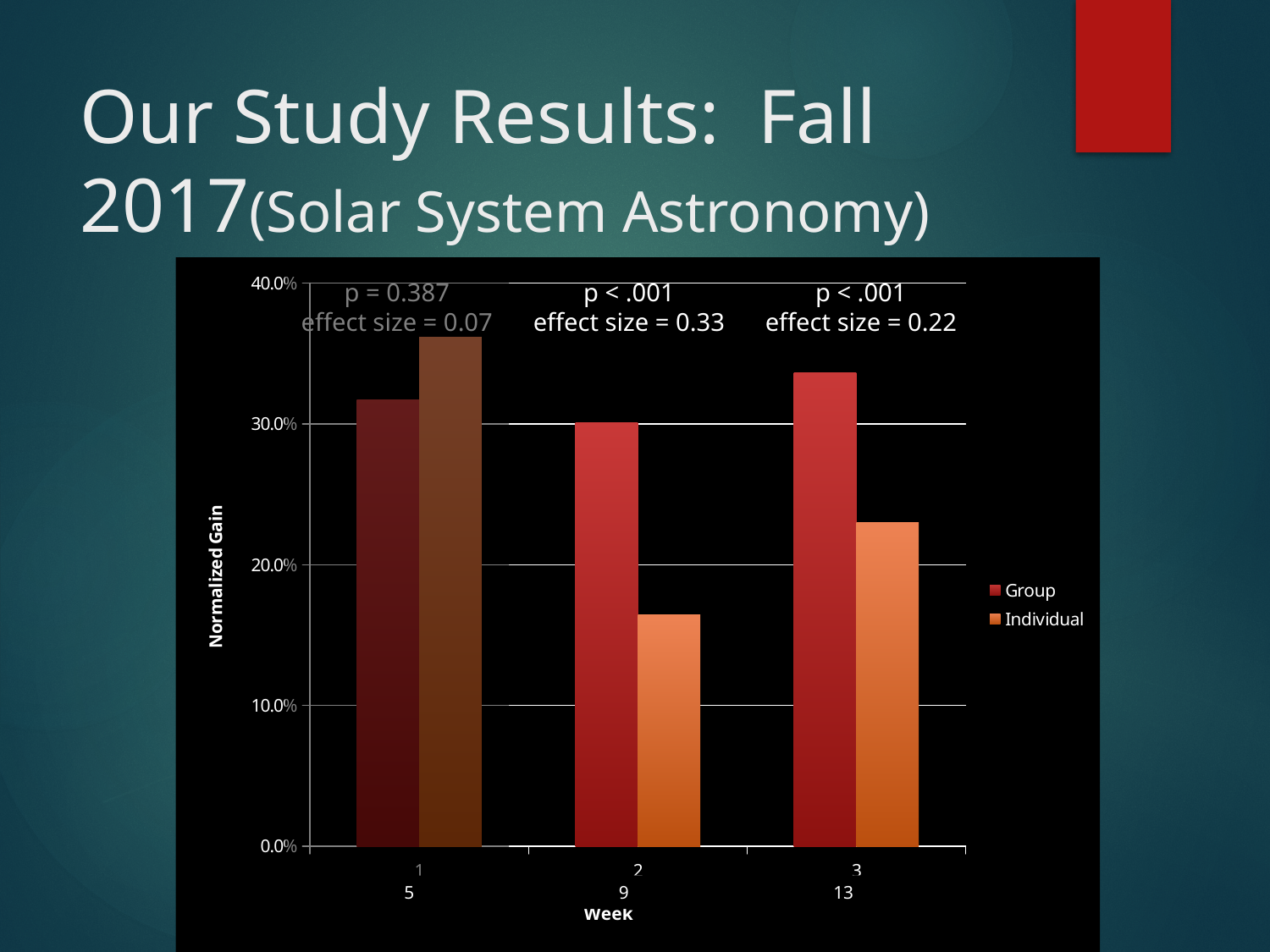
At week 9, which is larger, the Group bar or the Individual bar? Group Which week has the highest Individual value? 5 At week 13, which is larger, the Group bar or the Individual bar? Group What is the label on the vertical axis? Normalized Gain What kind of chart is shown on the slide? bar chart Is the Individual value at week 5 greater or less than 30.0%? greater How many weeks are shown on the x axis? 3 Is the Individual value at week 9 greater or less than 20.0%? less How many series does the legend list? 2 Is the Group value at week 13 greater or less than 30.0%? greater Which week has the lowest Individual value? 9 At week 5, which is larger, the Group bar or the Individual bar? Individual